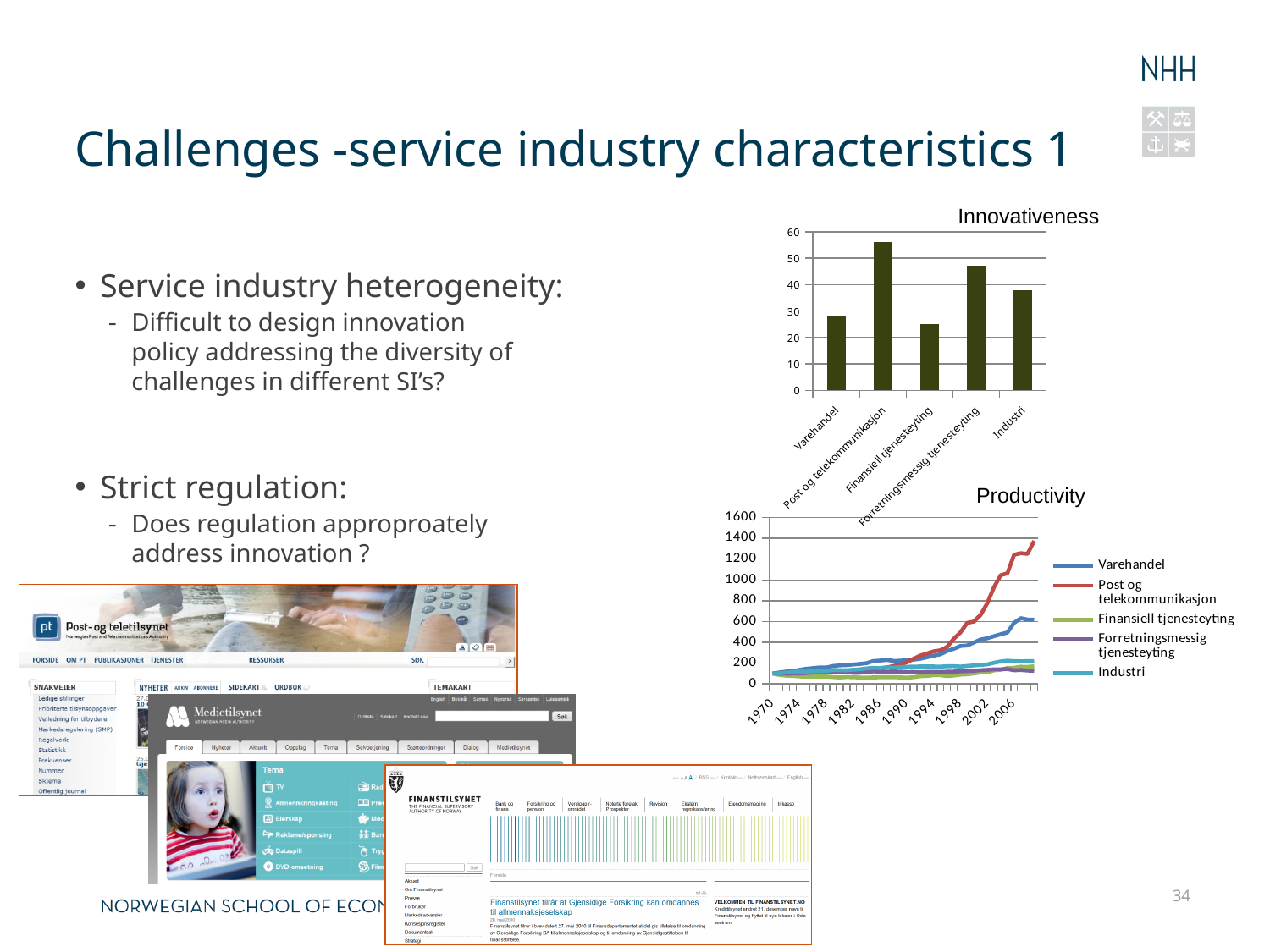
What kind of chart is the Innovativeness chart? bar chart In the Productivity chart, does the Post og telekommunikasjon series rise or fall from 1970 to the end of the period? rise What kind of chart is the Productivity chart? line chart In the Productivity chart, is the final value of the Post og telekommunikasjon series greater or less than 1200? greater In the Innovativeness chart, which category has the lowest value? Finansiell tjenesteyting How many series does the legend of the Productivity chart list? 5 In the Innovativeness chart, which category has the highest value? Post og telekommunikasjon How many categories are shown in the Innovativeness chart? 5 In the Productivity chart, which series reaches the highest value by the end of the period? Post og telekommunikasjon In the Innovativeness chart, which is larger: Forretningsmessig tjenesteyting or Varehandel? Forretningsmessig tjenesteyting In the Innovativeness chart, is the value for Industri greater or less than 40? less In the Innovativeness chart, is the value for Post og telekommunikasjon greater or less than 50? greater